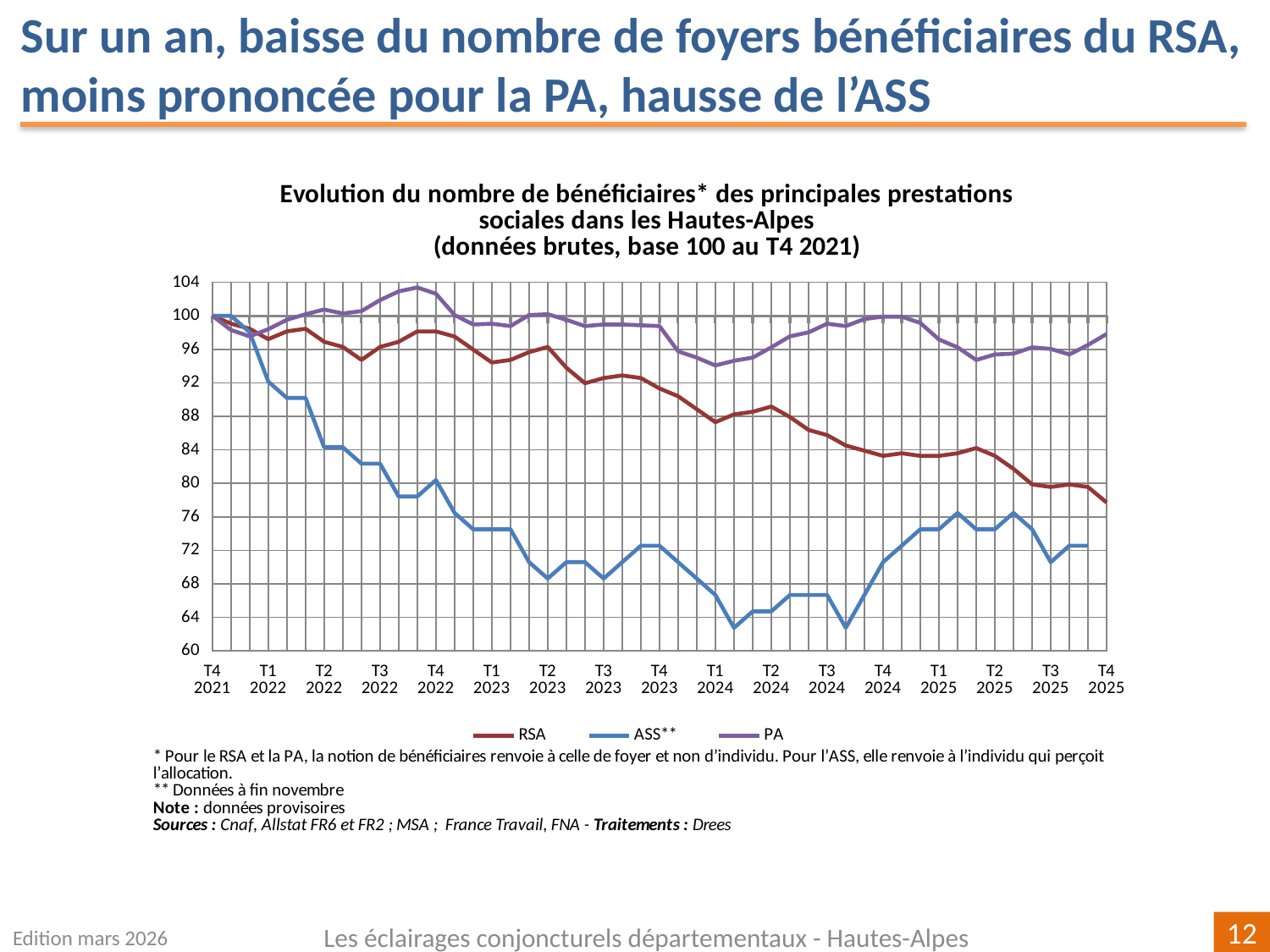
What is the value of the RSA series at T4 2021? 100 How many series does the legend list? 3 What kind of chart is shown on the slide? line chart Does the ASS** series rise or fall between T4 2021 and T4 2022? fall At T4 2025, which is larger: the value for PA or the value for RSA? PA Which series are listed in the legend? RSA, ASS**, PA Which series has the highest value at T4 2025? PA What is the value of the ASS** series at T4 2021? 100 Which series has the lowest value at T4 2025? RSA Is the value for RSA at T4 2025 greater or less than 80? less How many quarter labels are shown on the x axis? 17